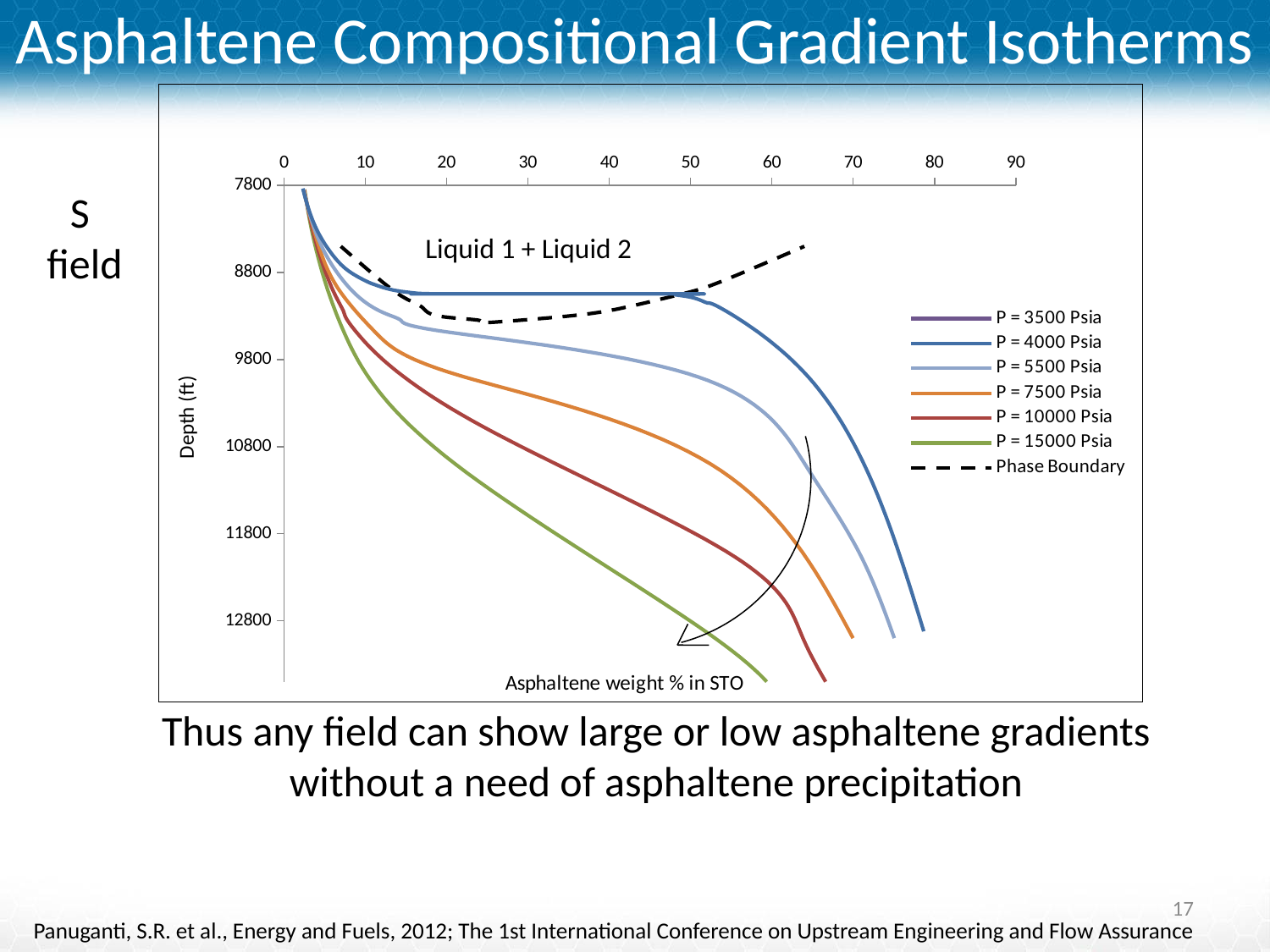
What is the label of the vertical axis? Depth (ft) As depth increases, does the asphaltene weight % in STO increase or decrease along each curve? increase What is the largest value shown on the horizontal axis? 90 At a depth of 12800 ft, is the asphaltene weight % for P = 4000 Psia greater or less than 70? greater Which legend entry is drawn as a dashed line? Phase Boundary How many entries does the chart legend list? 7 What label is written inside the plot area above the phase boundary? Liquid 1 + Liquid 2 What kind of chart is shown on the slide? line chart Which pressure series has the lowest asphaltene weight % at a depth of 12800 ft? P = 15000 Psia What is the label of the horizontal axis? Asphaltene weight % in STO At a depth of 10800 ft, is the asphaltene weight % for P = 15000 Psia greater or less than 30? less How many tick labels are shown on the depth axis? 6